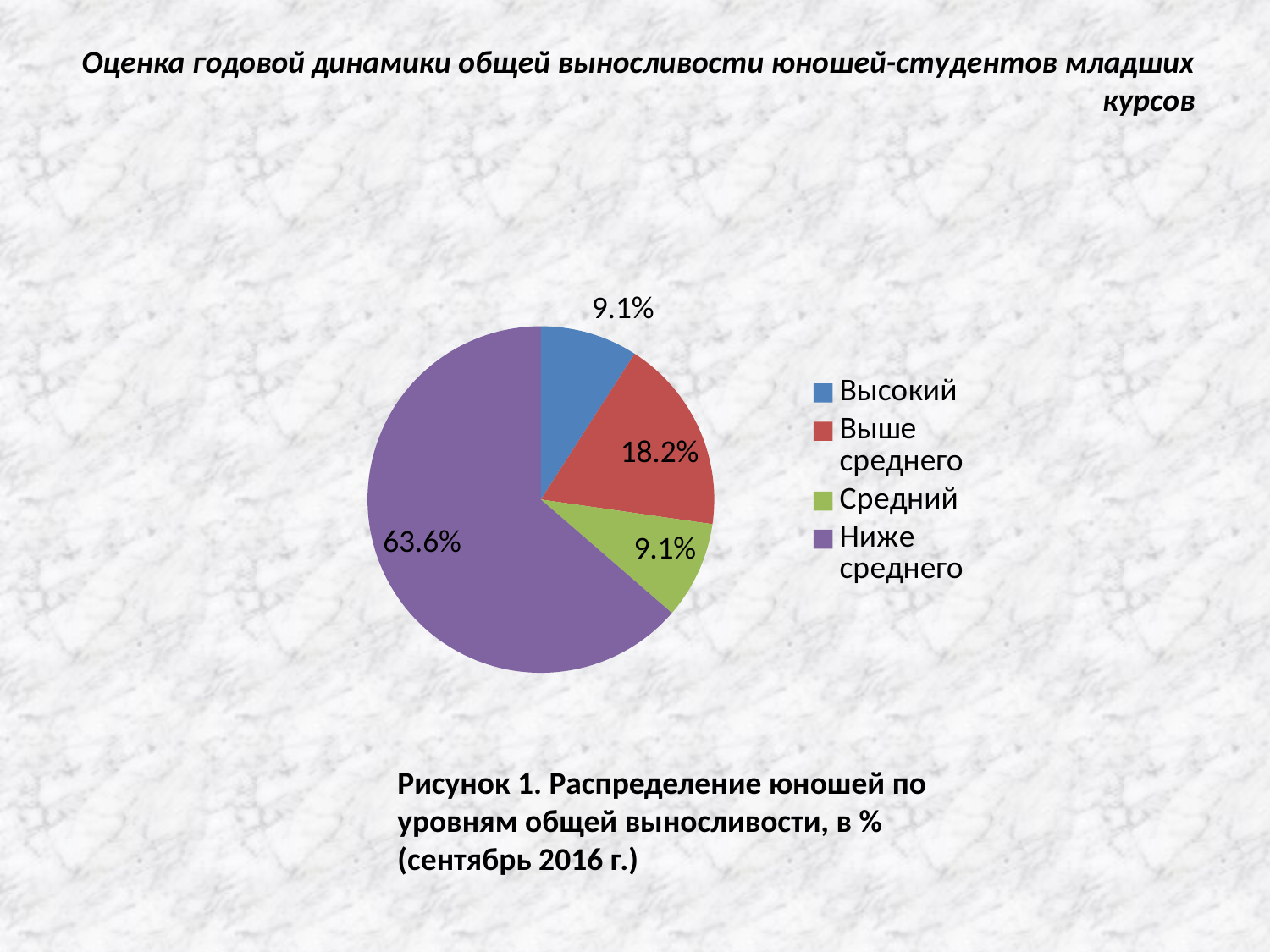
How many entries does the legend list? 4 Which category has the largest share of the pie? Ниже среднего How many slices does the pie chart have? 4 Which month and year does the chart caption say the data is from? сентябрь 2016 г. What percentage is shown for the 'Выше среднего' slice? 18.2% What percentage is shown for the 'Средний' slice? 9.1% What colour is the 'Ниже среднего' slice? Purple Which is larger, the 'Выше среднего' slice or the 'Средний' slice? Выше среднего What percentage of the pie is labelled for the 'Ниже среднего' slice? 63.6% What type of chart is shown on the slide? Pie chart What percentage is shown for the 'Высокий' slice? 9.1% What is the difference between the 'Ниже среднего' share and the 'Выше среднего' share? 45.4%